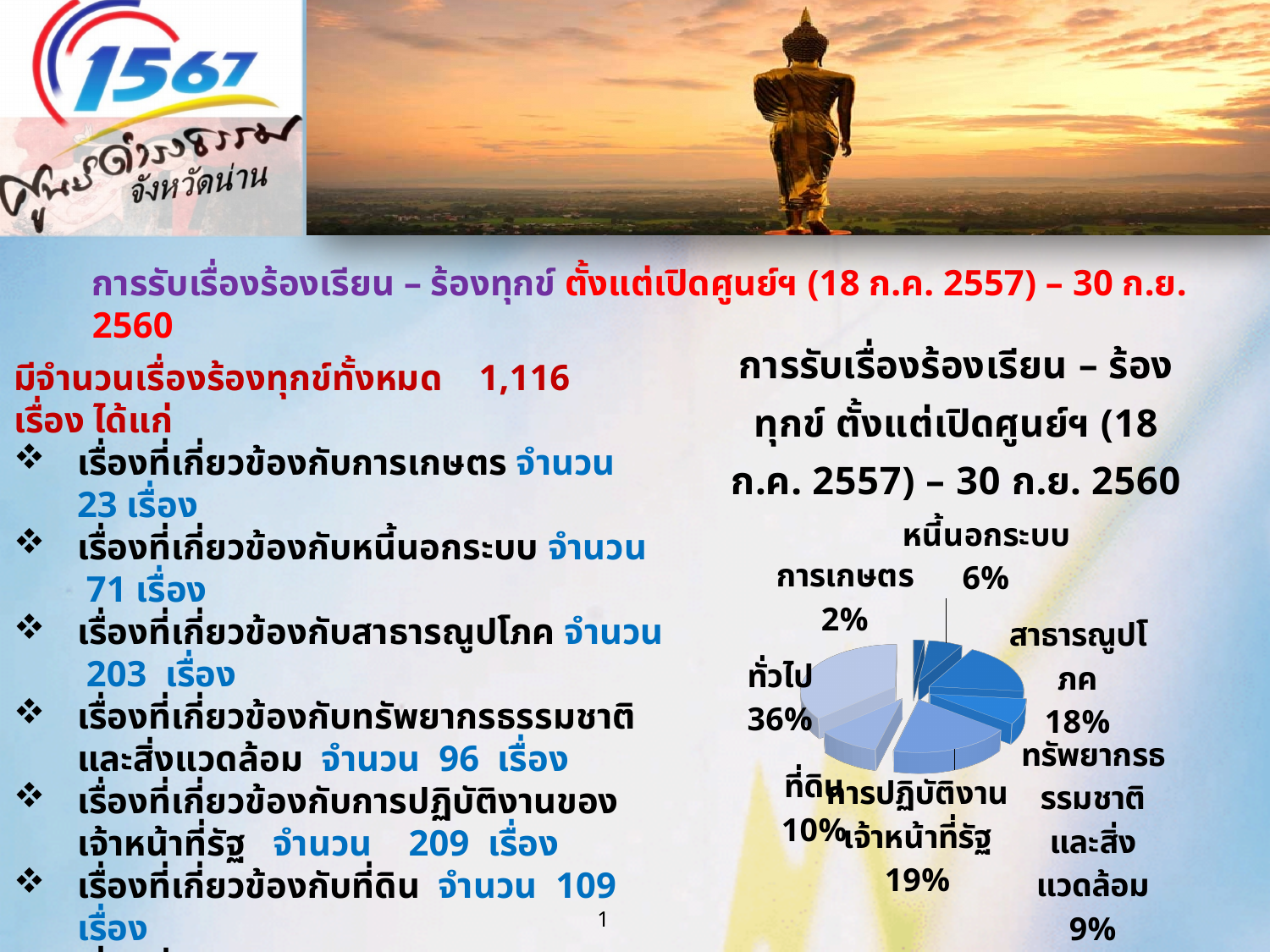
What percentage of the pie chart is labelled การเกษตร? 2% What percentage of the pie chart is labelled ทั่วไป? 36% What percentage of the pie chart is labelled สาธารณูปโภค? 18% What kind of chart is shown on the slide? pie chart What is the difference in percentage points between ทั่วไป and ที่ดิน in the pie chart? 26 What percentage of the pie chart is labelled หนี้นอกระบบ? 6% What is the share of the pie chart labelled ทรัพยากรธรรมชาติและสิ่งแวดล้อม? 9% What percentage of the pie chart is labelled ที่ดิน? 10% Which category has the smallest share of the pie chart? การเกษตร Which category has the largest share of the pie chart? ทั่วไป Which is larger in the pie chart, การปฏิบัติงานของเจ้าหน้าที่รัฐ or สาธารณูปโภค? การปฏิบัติงานของเจ้าหน้าที่รัฐ How many slices does the pie chart have? 7